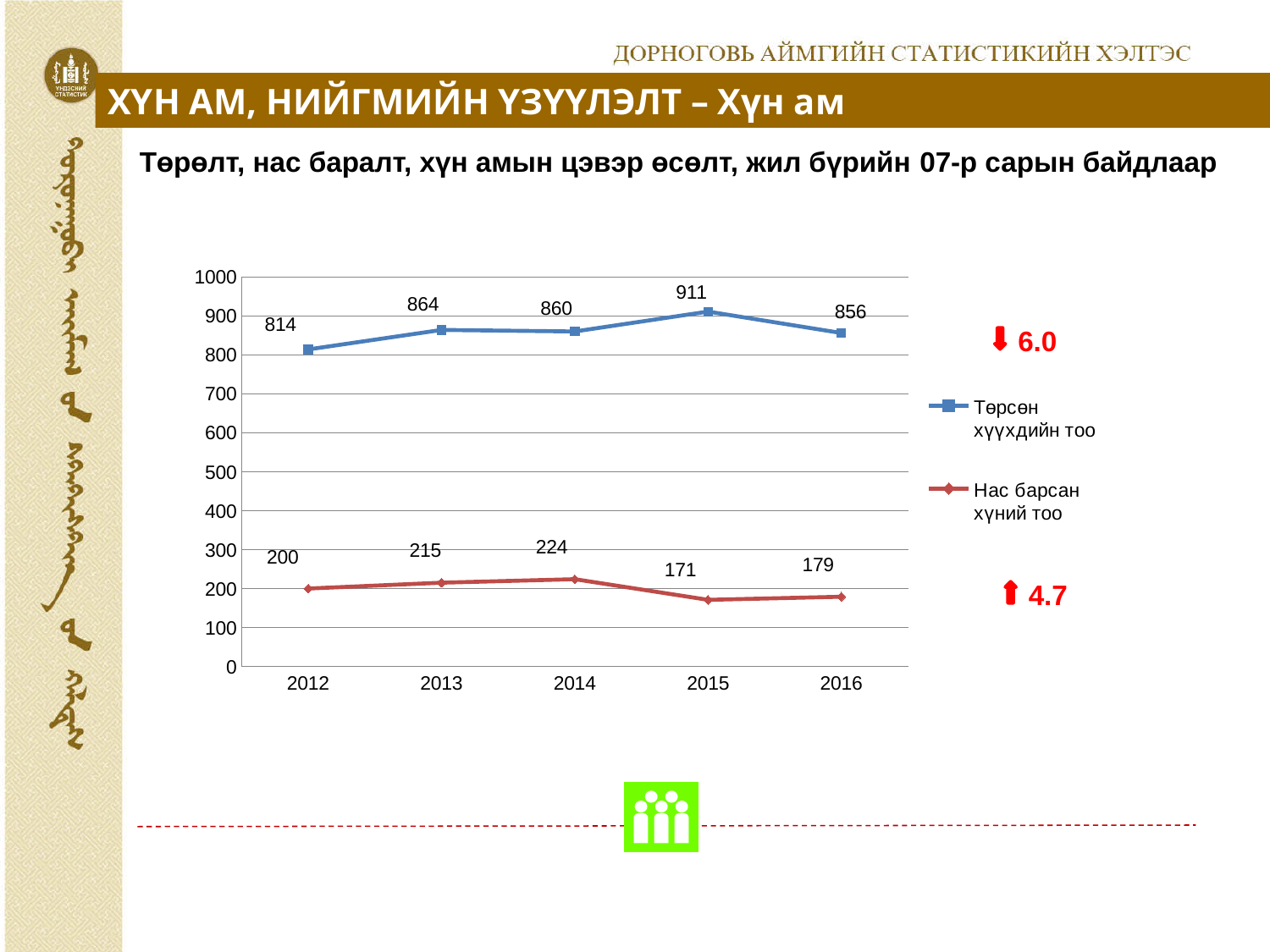
How many years are shown on the x axis? 5 What is the value of Төрсөн хүүхдийн тоо in 2012? 814 What is the value of Төрсөн хүүхдийн тоо in 2015? 911 Which is larger: Төрсөн хүүхдийн тоо in 2013 or in 2014? 2013 How many series does the legend list? 2 Does Нас барсан хүний тоо rise or fall from 2014 to 2015? fall What is the difference between Төрсөн хүүхдийн тоо in 2015 and 2016? 55 What is the difference between Нас барсан хүний тоо in 2014 and 2015? 53 In which year is Төрсөн хүүхдийн тоо highest? 2015 What is the value of Нас барсан хүний тоо in 2014? 224 What kind of chart is shown? line chart In which year is Нас барсан хүний тоо lowest? 2015